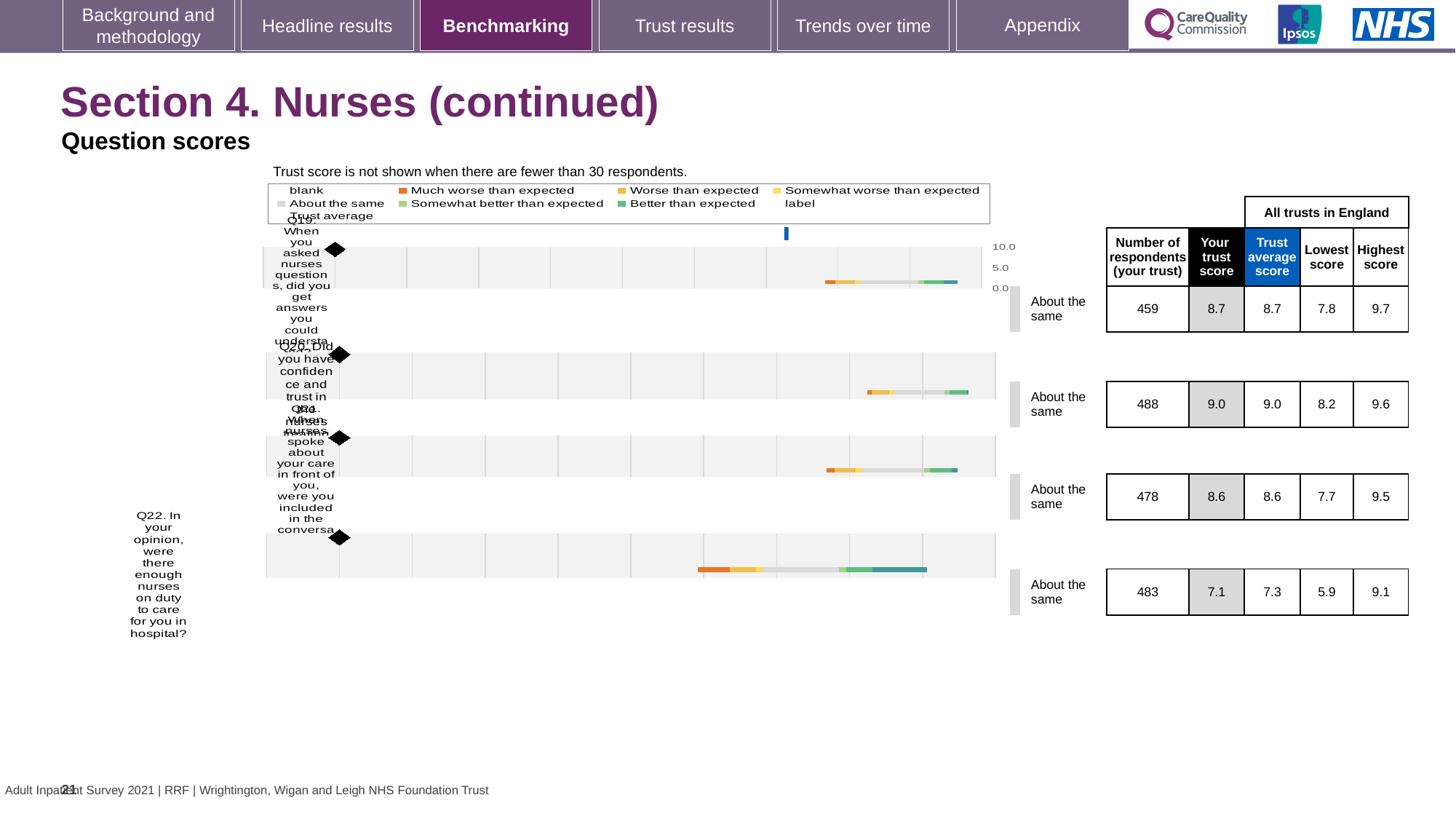
What kind of chart is used to show the question scores on this slide? Bar chart Which question has the highest 'Your trust score' on this slide? Q20 How many respondents from your trust answered Q22 about whether there were enough nurses on duty? 483 What is the highest score across all trusts in England for Q21? 9.5 What benchmark category label is shown next to each of the four questions? About the same What is the lowest score across all trusts in England for Q19? 7.8 What is your trust score for Q20 (confidence and trust in nurses)? 9.0 How many questions are plotted in the benchmarking chart on this slide? 4 Which question has the lowest 'Your trust score' on this slide? Q22 What is the trust average score for Q22? 7.3 For Q22, how much higher is the trust average score than your trust score? 0.2 For Q22, what is the difference between the highest score and the lowest score across all trusts in England? 3.2